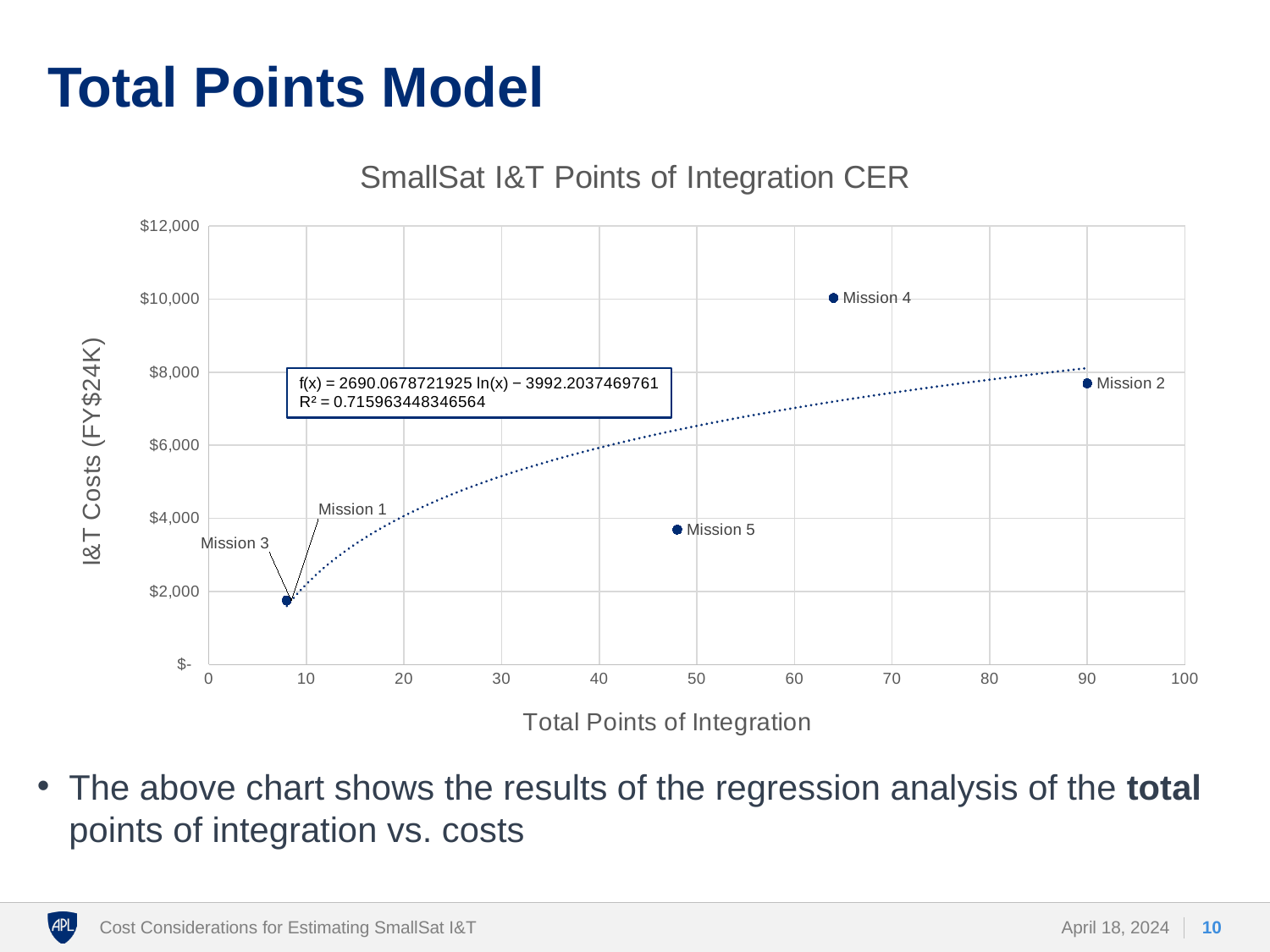
Is the I&T cost for Mission 5 greater or less than $4,000? less How many missions are plotted on the chart? 5 Which mission has the highest I&T cost? Mission 4 Is the total points of integration for Mission 2 greater or less than 80? greater Is the I&T cost for Mission 3 greater or less than $4,000? less What kind of chart is shown on the slide? scatter chart Which has the higher I&T cost, Mission 4 or Mission 5? Mission 4 Which has the higher I&T cost, Mission 2 or Mission 5? Mission 2 What is the title of the chart? SmallSat I&T Points of Integration CER What R² value is shown for the trend line on the chart? 0.715963448346564